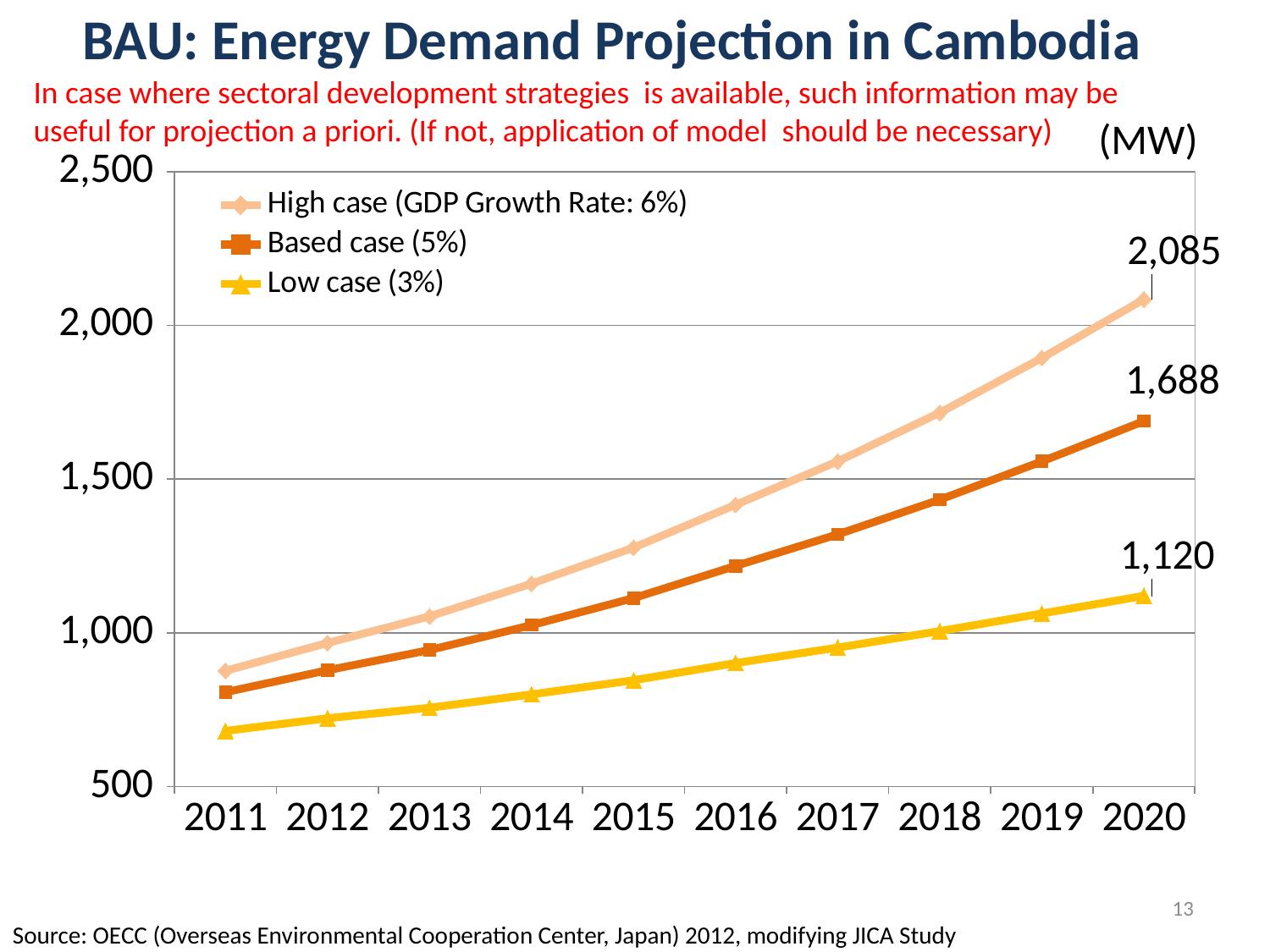
Is the value for the Low case (3%) series in 2011 greater or less than 1,000? less What is the value for the Low case (3%) series in 2020? 1,120 Is the value for the High case series in 2017 greater or less than 1,500? greater What kind of chart is shown on the slide? Line chart What is the value for the Based case (5%) series in 2020? 1,688 What is the difference between the High case and the Based case values in 2020? 397 Do the values of the Based case (5%) series rise or fall from 2011 to 2020? Rise Which series has the highest value in 2020? High case (GDP Growth Rate: 6%) What is the value for the High case (GDP Growth Rate: 6%) series in 2020? 2,085 How many series does the legend list? 3 What is the difference between the Based case and the Low case values in 2020? 568 Which series has the lowest value in 2020? Low case (3%)